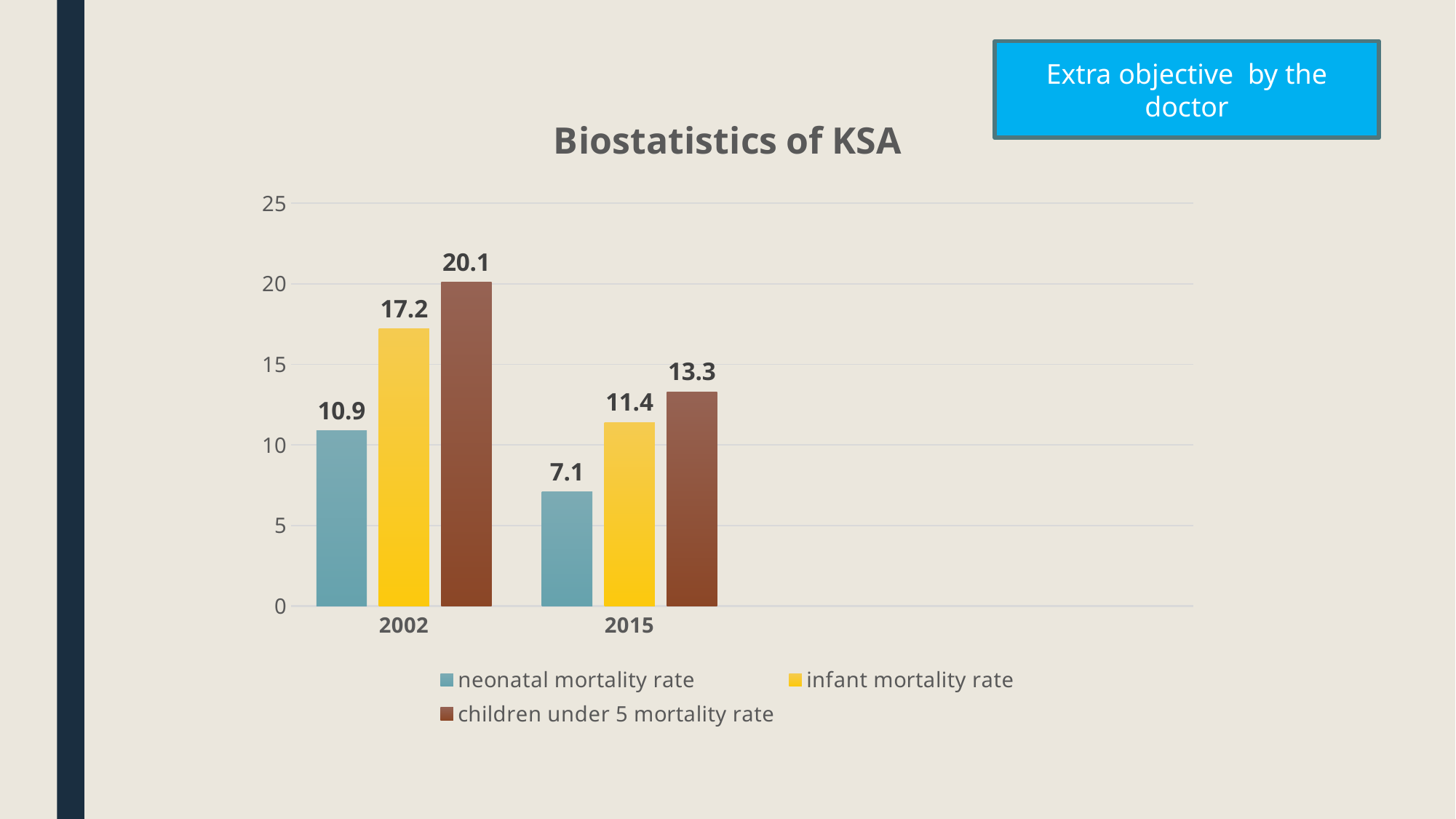
Which series has the highest value in 2015? children under 5 mortality rate What is the infant mortality rate for 2015? 11.4 Which is larger: the infant mortality rate in 2002 or the children under 5 mortality rate in 2015? infant mortality rate in 2002 Does the infant mortality rate rise or fall from 2002 to 2015? fall What kind of chart is shown on the slide? bar chart How many series does the legend list? 3 How many years are shown on the x axis? 2 Which series has the lowest value in 2002? neonatal mortality rate What is the children under 5 mortality rate for 2002? 20.1 What is the difference between the children under 5 mortality rate in 2002 and in 2015? 6.8 Is the neonatal mortality rate for 2015 greater or less than 10? less What is the neonatal mortality rate for 2002? 10.9